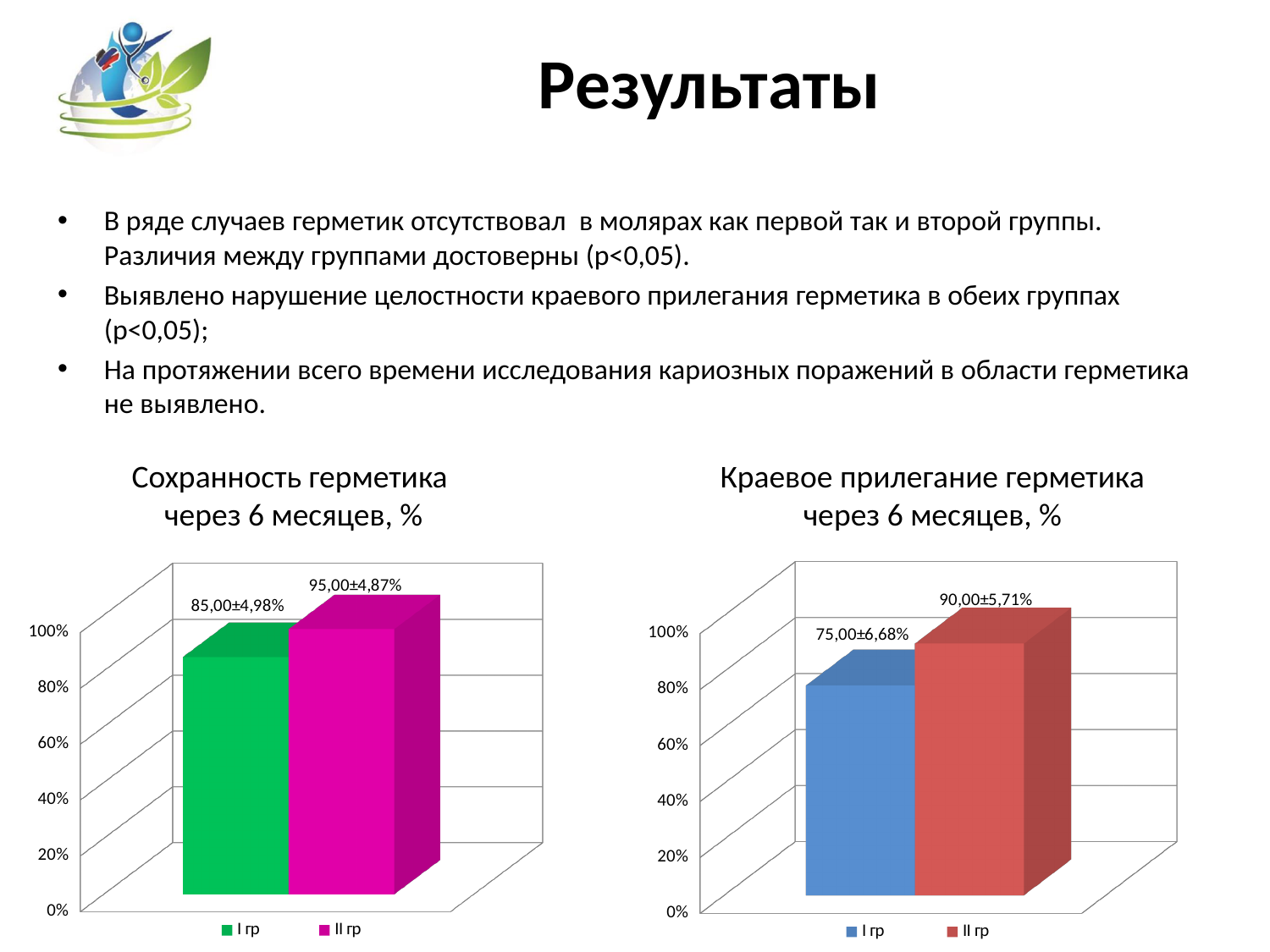
In the chart titled "Краевое прилегание герметика через 6 месяцев, %", what is the data label for I гр? 75,00±6,68% In the left chart (Сохранность герметика), is the value for II гр greater or less than 80%? greater In the chart titled "Краевое прилегание герметика через 6 месяцев, %", what is the data label for II гр? 90,00±5,71% In the right chart (Краевое прилегание герметика), which group has the lower value? I гр In the chart titled "Сохранность герметика через 6 месяцев, %", what is the data label for I гр? 85,00±4,98% In the left chart (Сохранность герметика), which group has the higher value? II гр In the right chart (Краевое прилегание герметика), what colour is the bar for II гр? Red How many series does the legend of the left chart (Сохранность герметика) list? 2 What kind of chart is the left chart titled "Сохранность герметика через 6 месяцев, %"? Bar chart How many bars are plotted in the right chart (Краевое прилегание герметика)? 2 In the chart titled "Сохранность герметика через 6 месяцев, %", what is the data label for II гр? 95,00±4,87% In the right chart (Краевое прилегание герметика), is the value for I гр greater or less than 80%? less